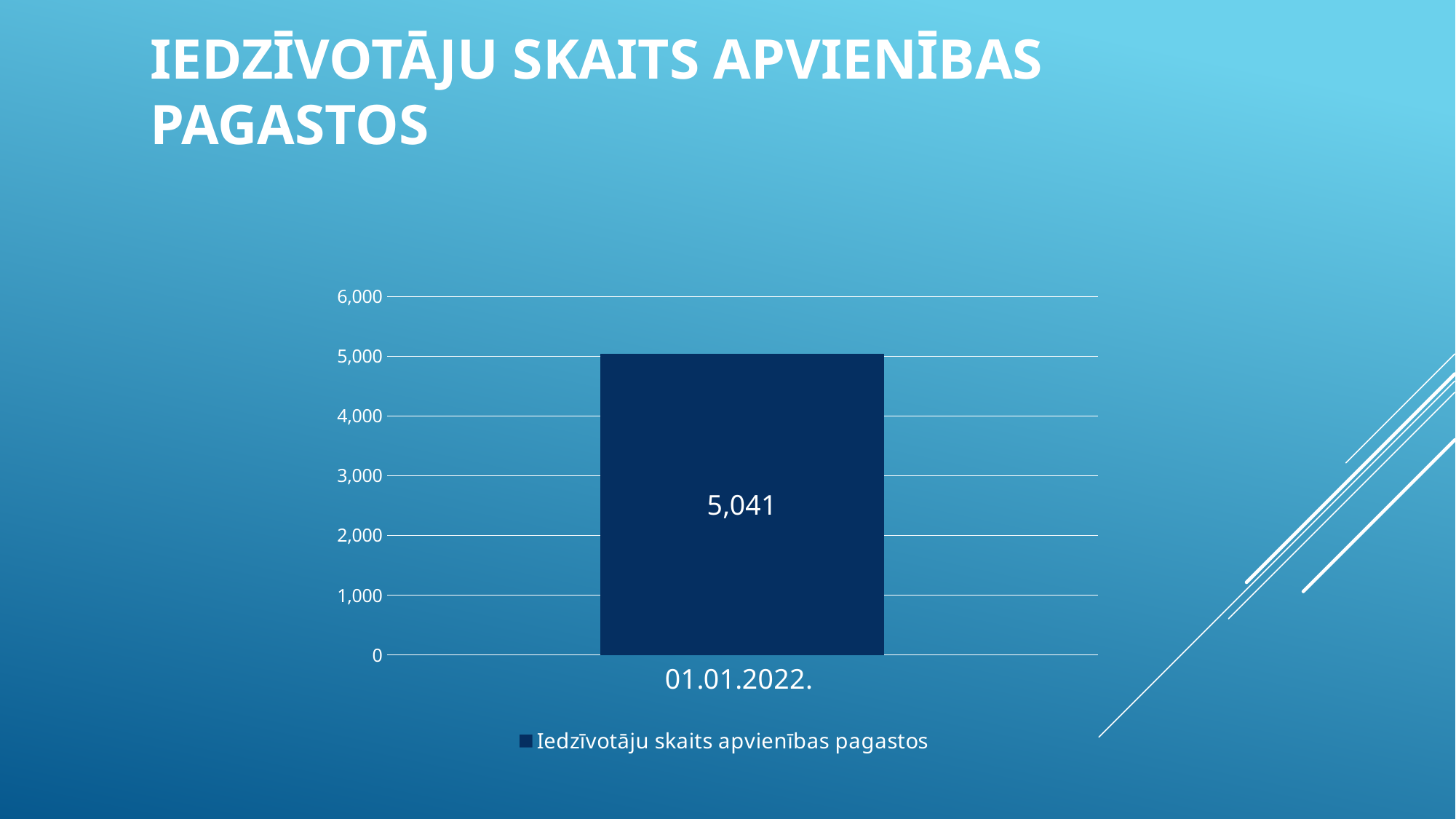
What kind of chart is shown on the slide? bar chart What is the highest value shown on the y axis? 6,000 Is the value for 01.01.2022. greater or less than 6,000? less What is the category label shown on the x axis? 01.01.2022. How many bars does the chart contain? 1 How many series does the legend list? 1 What is the value shown for 01.01.2022. in the chart? 5,041 Is the value for 01.01.2022. greater or less than 5,000? greater What series name is shown in the legend? Iedzīvotāju skaits apvienības pagastos